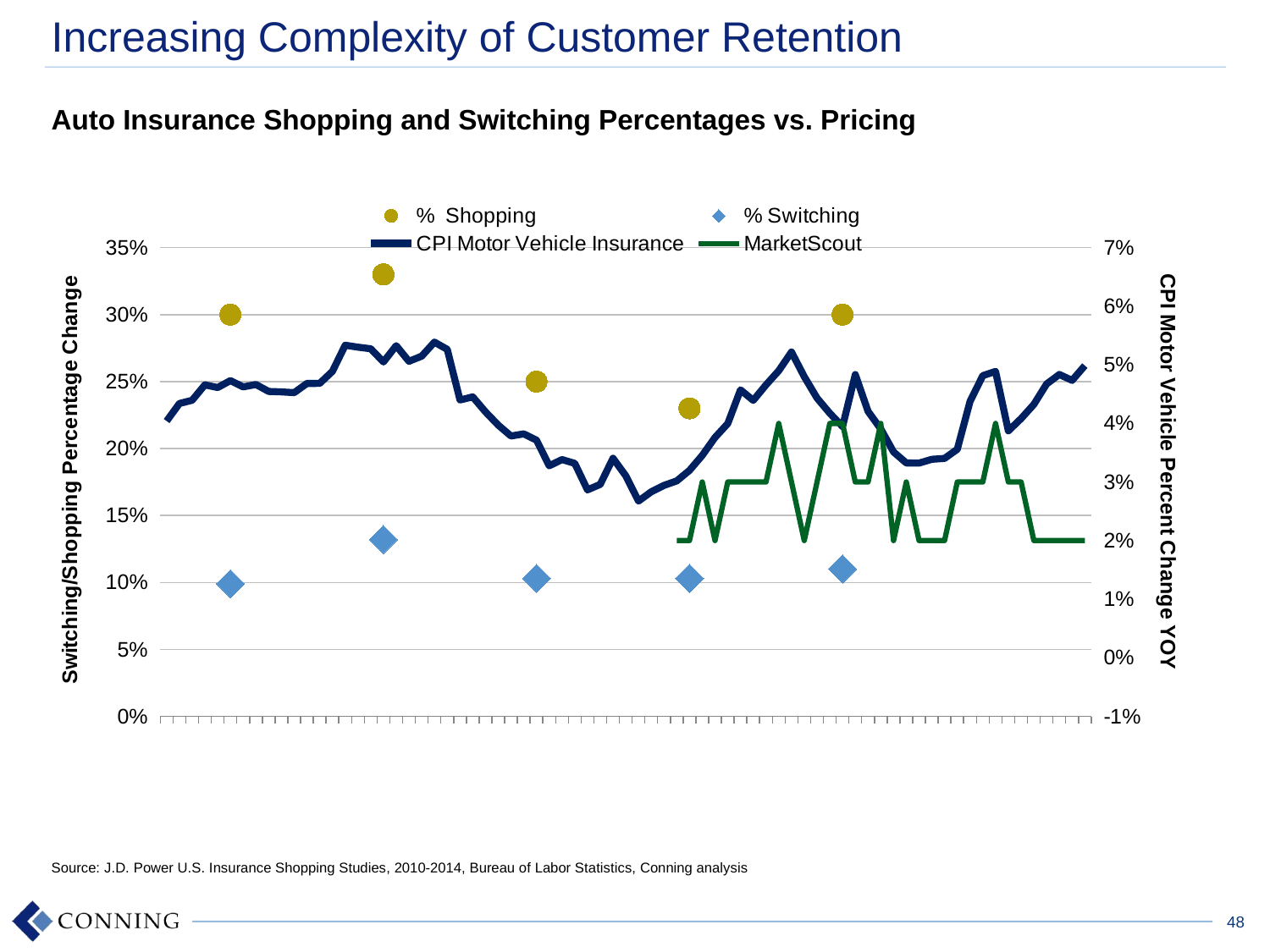
Is the highest % Shopping point greater or less than 30%? greater What is the title of the chart? Auto Insurance Shopping and Switching Percentages vs. Pricing What is the title of the right-hand vertical axis? CPI Motor Vehicle Percent Change YOY How many % Switching data points are plotted on the chart? 5 How many series does the chart legend list? 4 How many % Shopping data points are plotted on the chart? 5 What is the value of the leftmost % Shopping point? 30% Is the peak of the MarketScout line greater or less than 5% on the right axis? less Which series is plotted with a green line? MarketScout Which is higher, the second % Shopping point from the left or the fourth % Shopping point from the left? the second % Shopping point What is the value of the middle (third from left) % Shopping point? 25% What is the value of the rightmost % Shopping point? 30%